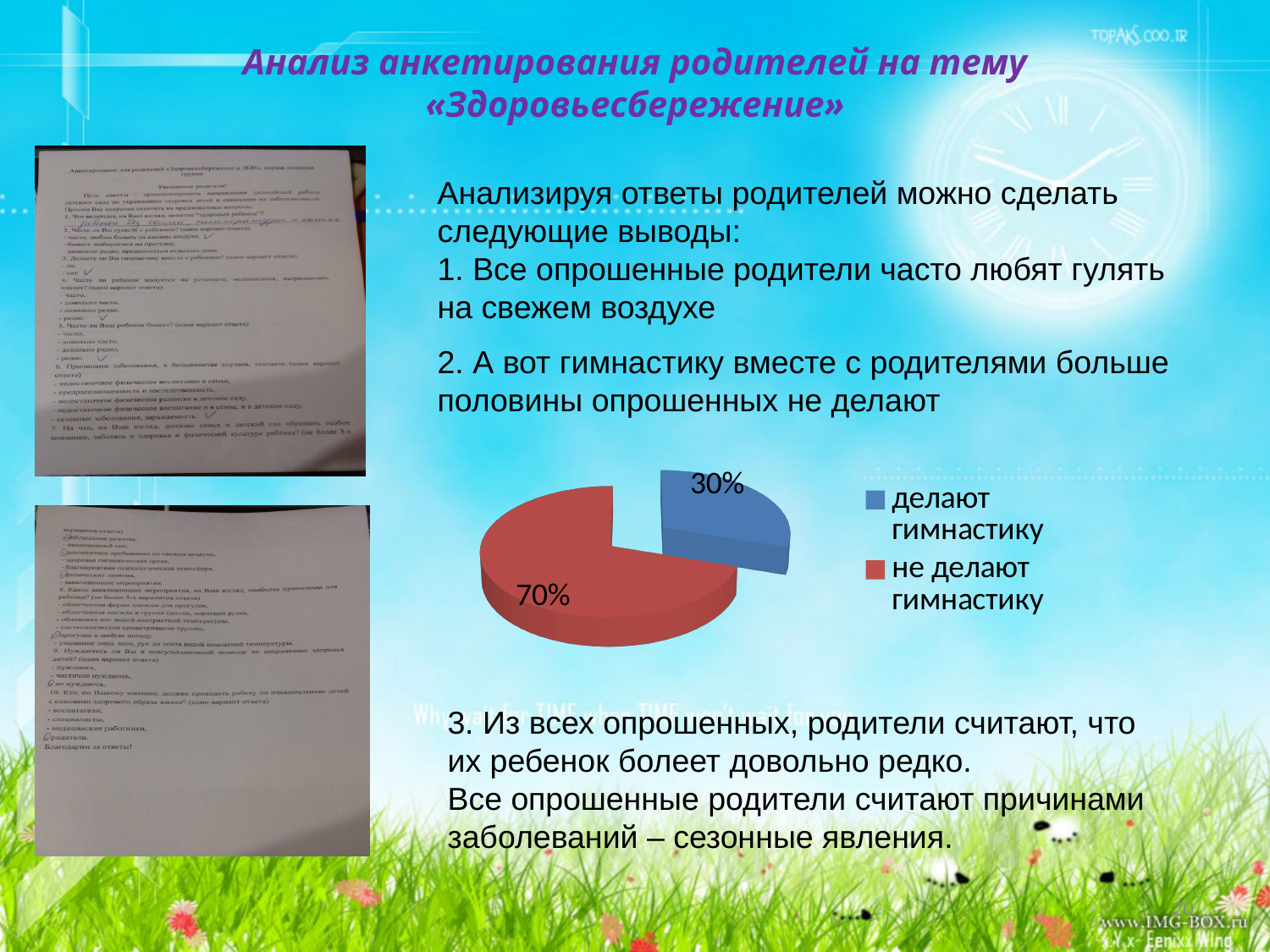
Which is larger: the share for "делают гимнастику" or the share for "не делают гимнастику"? не делают гимнастику Which category has the smallest slice of the pie? делают гимнастику What colour is the "не делают гимнастику" slice in the pie chart? red What share of the pie is labelled "не делают гимнастику"? 70% What is the difference in percentage points between the "не делают гимнастику" slice and the "делают гимнастику" slice? 40 How many entries does the legend of the pie chart list? 2 What colour is the "делают гимнастику" slice in the pie chart? blue How many slices does the pie chart have? 2 Which category has the largest slice of the pie? не делают гимнастику What is the total of the two percentages shown on the pie chart? 100% What kind of chart is shown on the slide? pie chart What share of the pie is labelled "делают гимнастику"? 30%